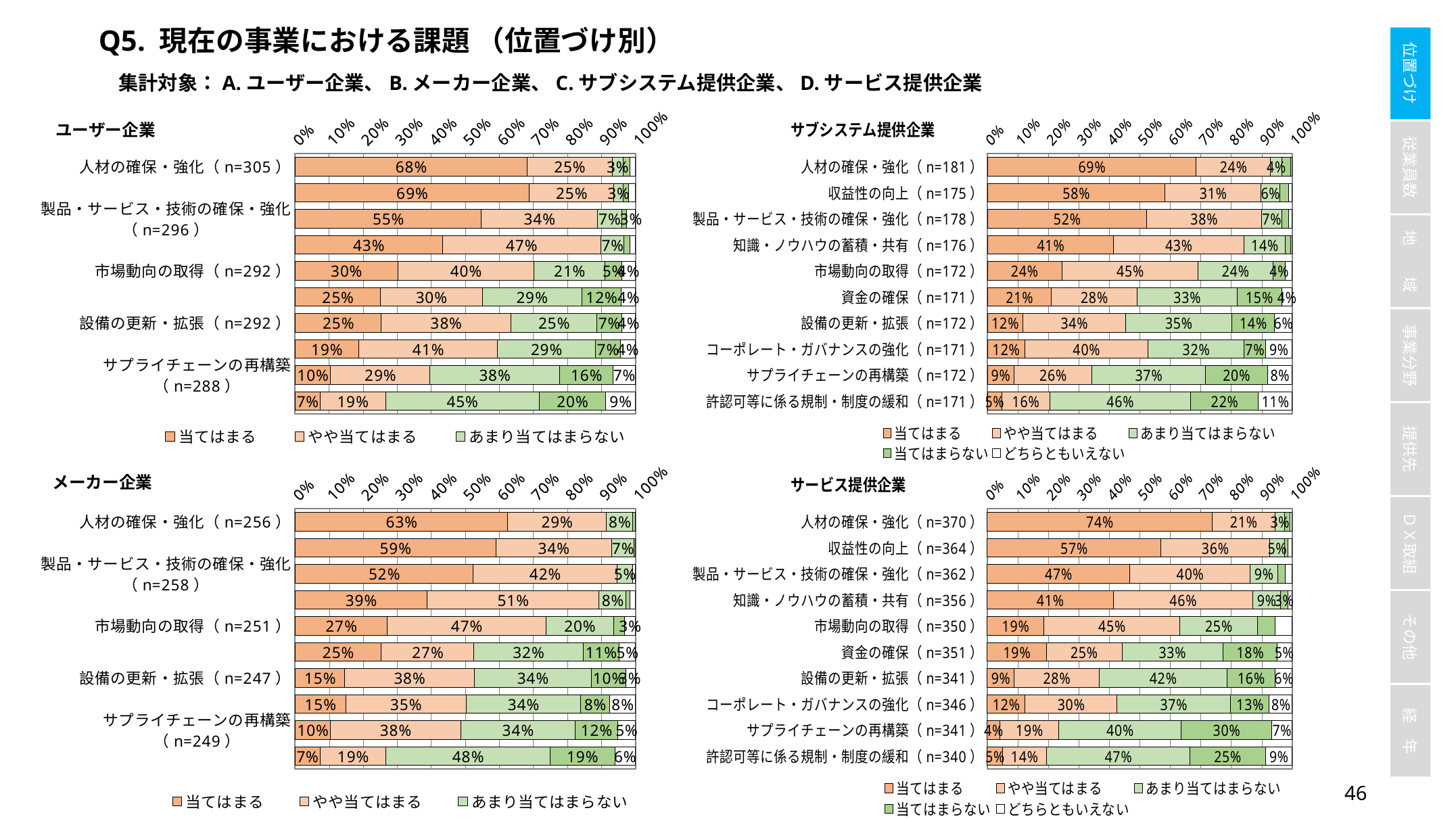
In the サブシステム提供企業 chart, which category has the highest 当てはまる value? 人材の確保・強化 In the サブシステム提供企業 chart, what is the 当てはまる value for 人材の確保・強化? 69% In the サブシステム提供企業 chart, which is larger: the 当てはまる value for 収益性の向上 or for 製品・サービス・技術の確保・強化? 収益性の向上 What kind of chart is the メーカー企業 chart? Stacked bar chart In the メーカー企業 chart, what is the 当てはまる value for 人材の確保・強化 (n=256)? 63% In the サービス提供企業 chart, what is the 当てはまる value for 人材の確保・強化? 74% In the サービス提供企業 chart, what is the あまり当てはまらない value for 許認可等に係る規制・制度の緩和? 47% In the サービス提供企業 chart, what is the difference between the 当てはまる values for 人材の確保・強化 and 収益性の向上? 17% How many categories are shown in the サブシステム提供企業 chart? 10 In the ユーザー企業 chart, what is the あまり当てはまらない value for サプライチェーンの再構築 (n=288)? 38% How many series does the legend of the サービス提供企業 chart list? 5 In the サブシステム提供企業 chart, which category has the lowest 当てはまる value? 許認可等に係る規制・制度の緩和